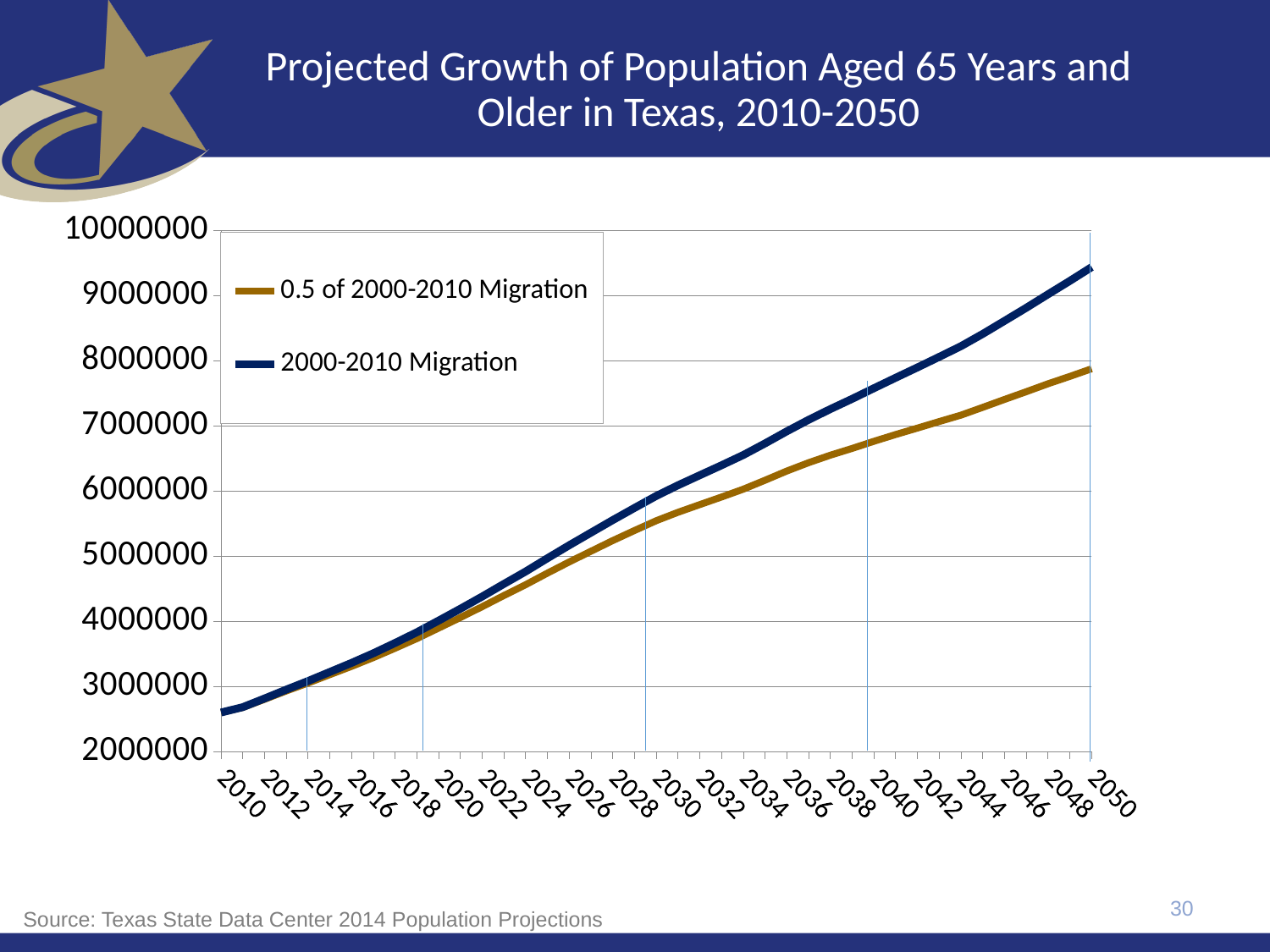
Is the value for the 2000-2010 Migration series in 2040 greater or less than 7000000? greater Which series has the higher value in 2050? 2000-2010 Migration Is the value for the 2000-2010 Migration series in 2010 greater or less than 3000000? less What is the title of the chart? Projected Growth of Population Aged 65 Years and Older in Texas, 2010-2050 Do the values for the 2000-2010 Migration series rise or fall from 2010 to 2050? rise How many series does the legend list? 2 Is the value for the 0.5 of 2000-2010 Migration series in 2040 greater or less than 7000000? less Which series has the higher value in 2040? 2000-2010 Migration What kind of chart is shown on the slide? line chart What are the two series named in the legend? 0.5 of 2000-2010 Migration; 2000-2010 Migration